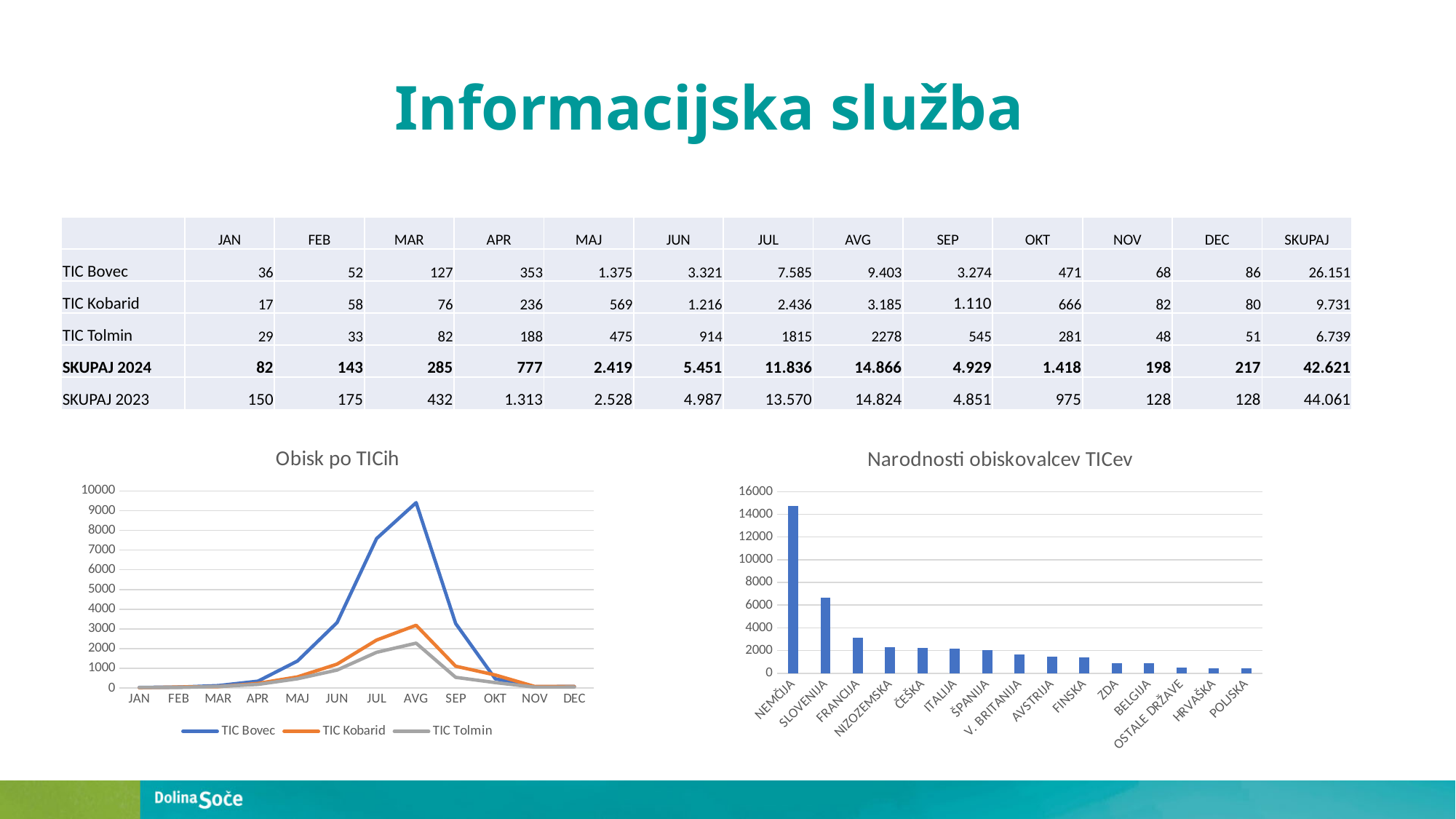
In the "Obisk po TICih" chart, is the value for TIC Bovec in AVG greater or less than 9000? greater In the "Obisk po TICih" chart, does the TIC Bovec line rise or fall from JAN to AVG? rise In the "Obisk po TICih" chart, how many series does the legend list? 3 In the "Narodnosti obiskovalcev TICev" chart, is the value for SLOVENIJA greater or less than 6000? greater In the "Obisk po TICih" chart, which series has the highest value in JUL? TIC Bovec In the "Obisk po TICih" chart, which month has the highest value for TIC Bovec? AVG What kind of chart is "Obisk po TICih"? line chart In the "Narodnosti obiskovalcev TICev" chart, which is larger, the value for FRANCIJA or the value for ZDA? FRANCIJA In the "Narodnosti obiskovalcev TICev" chart, how many categories are shown on the x axis? 15 In the "Obisk po TICih" chart, is the value for TIC Bovec in SEP greater or less than 4000? less In the "Narodnosti obiskovalcev TICev" chart, which category has the highest value? NEMČIJA What kind of chart is "Narodnosti obiskovalcev TICev"? bar chart